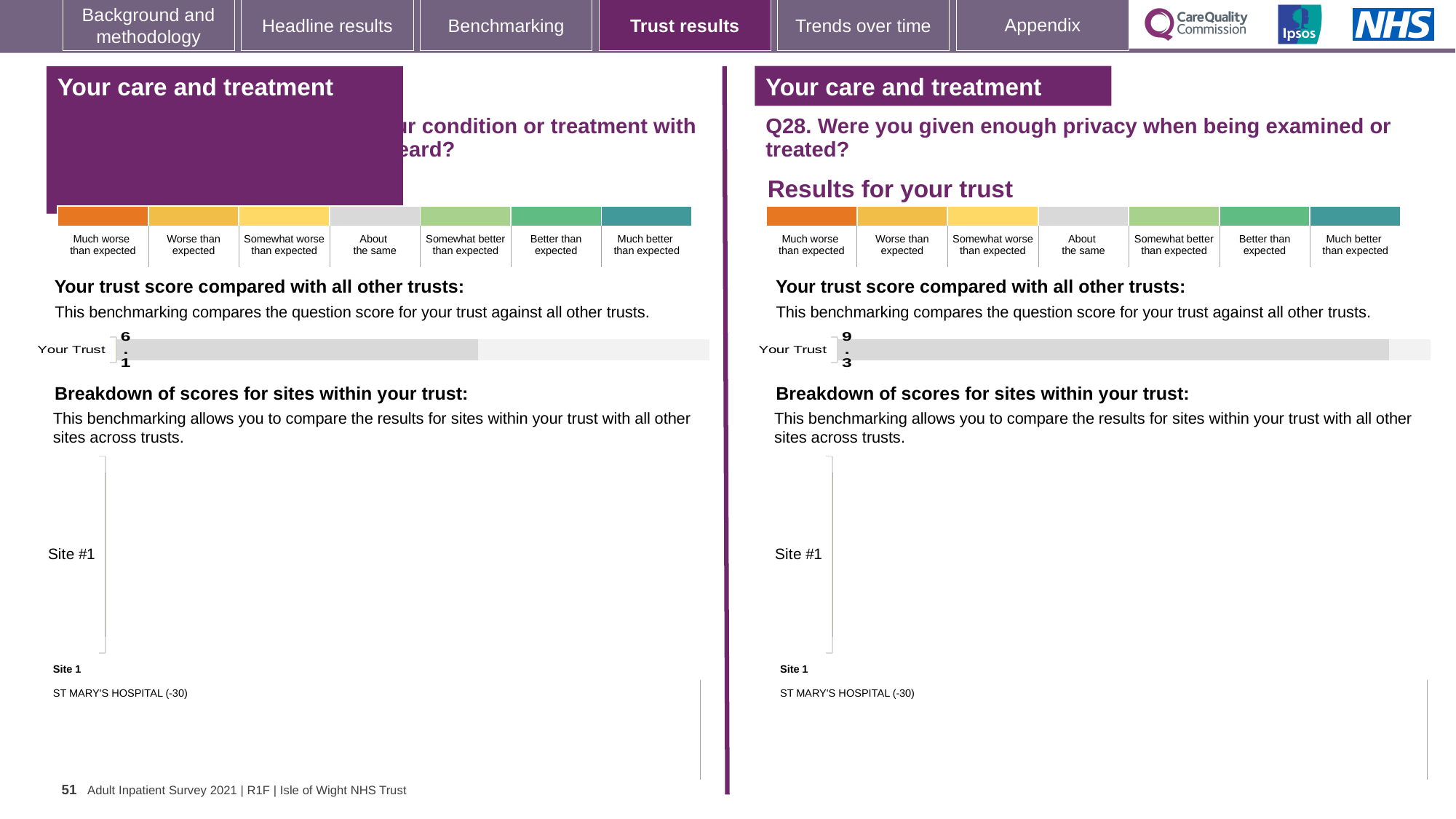
How many categories are plotted in the 'Your trust score compared with all other trusts' chart on the right-hand side (Q28)? 1 What is the difference between the Your Trust score on the right-hand chart (Q28) and the Your Trust score on the left-hand chart? 3.2 How many rating bands are shown in the colour key above the right-hand chart (Q28)? 7 On the left-hand chart, what is the score shown for Your Trust? 6.1 On the right-hand chart (Q28), what is the score shown for Your Trust? 9.3 Which chart shows the higher Your Trust score, the left-hand chart or the right-hand chart (Q28)? The right-hand chart (Q28) On the right-hand chart (Q28), what is the label of the single bar in the trust score chart? Your Trust What kind of chart is used to show the Your Trust score on the right-hand chart (Q28)? Bar chart Which site is listed as Site 1 under the right-hand chart (Q28)? ST MARY'S HOSPITAL (-30)